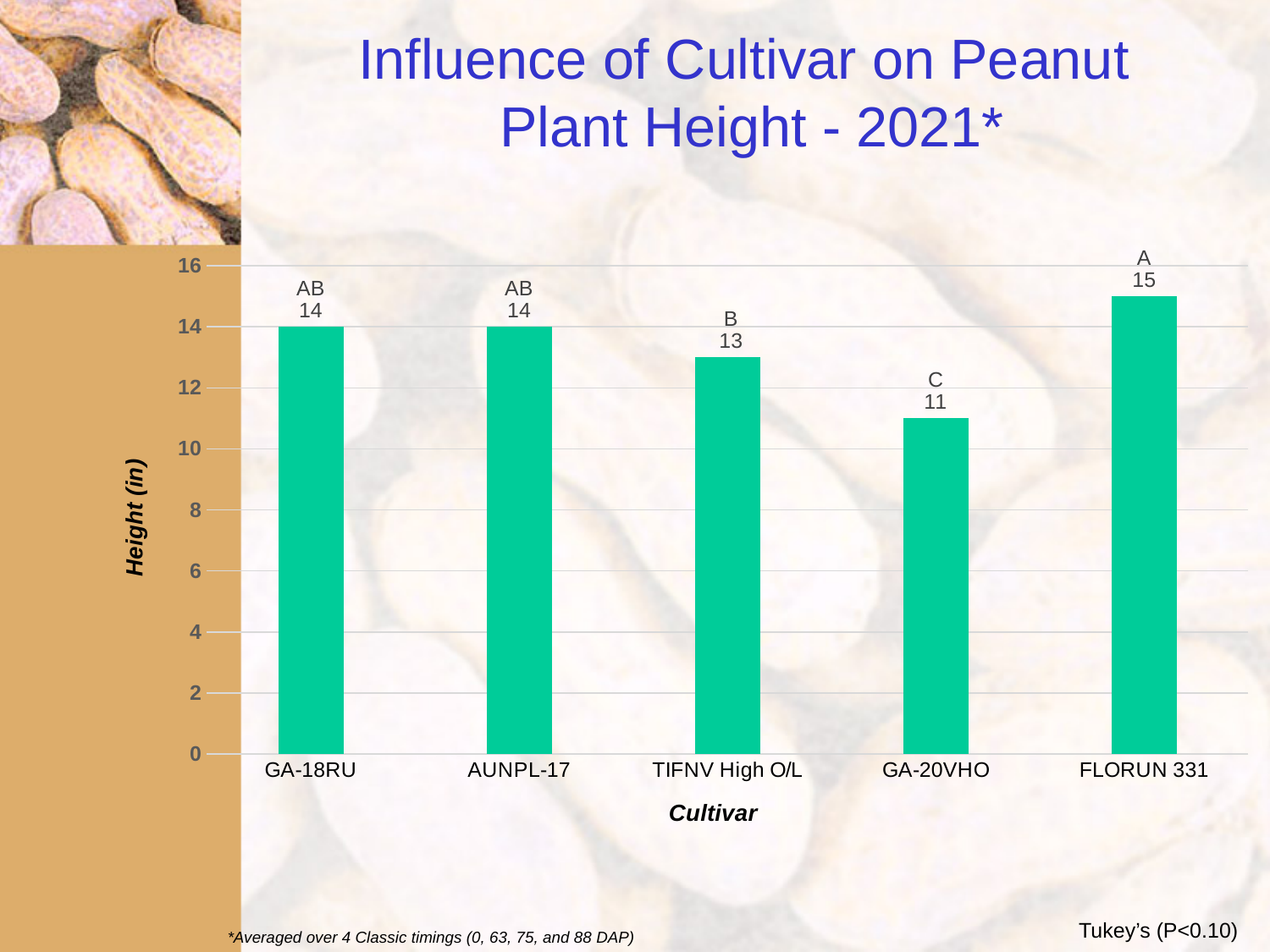
What is the plant height for GA-18RU? 14 Which cultivar has the greatest plant height? FLORUN 331 What is the plant height for TIFNV High O/L? 13 Which cultivar has the lowest plant height? GA-20VHO Is the value for GA-20VHO greater or less than 12? less What is the plant height for GA-20VHO? 11 What kind of chart is shown on the slide? bar chart Which has a greater plant height, AUNPL-17 or TIFNV High O/L? AUNPL-17 What is the label of the y axis? Height (in) What is the plant height for FLORUN 331? 15 How many cultivars are shown on the chart? 5 What is the difference in plant height between FLORUN 331 and GA-20VHO? 4